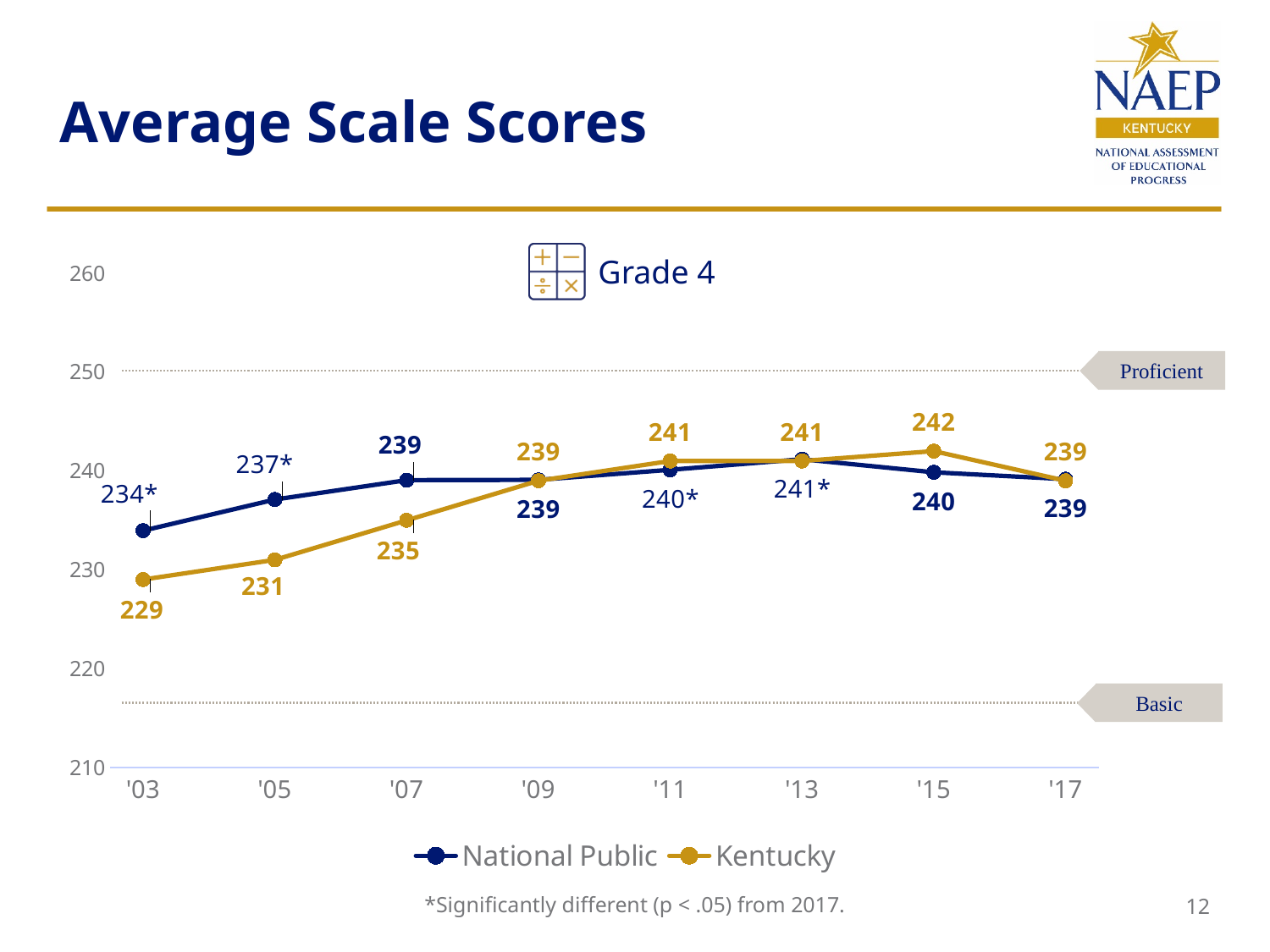
In which year is the Kentucky series at its lowest value? '03 What kind of chart is shown on the slide? Line chart What is the Kentucky average scale score for '07? 235 What is the National Public average scale score for '15? 240 What is the National Public average scale score for '03, as labelled on the chart? 234* How many years are shown on the x axis? 8 Does the Kentucky series rise or fall from '03 to '09? Rise What is the difference between the Kentucky score in '15 and the Kentucky score in '03? 13 In which year does the Kentucky series reach its highest value? '15 What is the Kentucky average scale score for '03? 229 Which series has the higher value in '05, National Public or Kentucky? National Public How many series does the legend list? 2